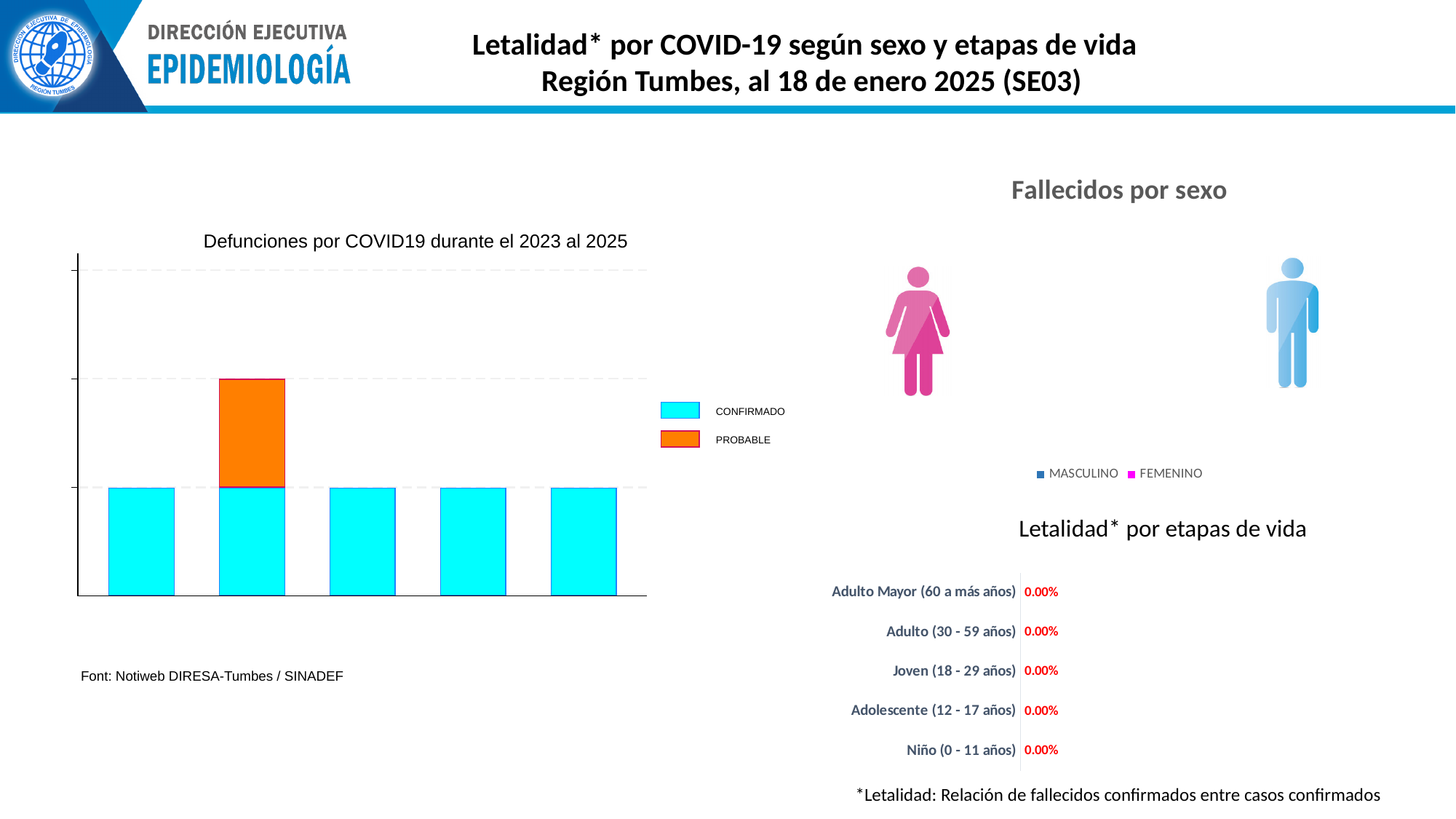
In the chart titled 'Letalidad* por etapas de vida', what is the value for Adulto Mayor (60 a más años)? 0.00% In the chart titled 'Letalidad* por etapas de vida', what is the value for Joven (18 - 29 años)? 0.00% In the chart titled 'Defunciones por COVID19 durante el 2023 al 2025', what kind of chart is shown? Bar chart In the chart titled 'Letalidad* por etapas de vida', what is the value for Niño (0 - 11 años)? 0.00% In the chart titled 'Defunciones por COVID19 durante el 2023 al 2025', what are the two legend entries? CONFIRMADO and PROBABLE In the chart titled 'Defunciones por COVID19 durante el 2023 al 2025', how many bars include an orange PROBABLE segment? 1 In the chart titled 'Defunciones por COVID19 durante el 2023 al 2025', how many series does the legend list? 2 In the chart titled 'Defunciones por COVID19 durante el 2023 al 2025', how many bars are plotted? 5 In the chart titled 'Fallecidos por sexo', how many series does the legend list? 2 In the chart titled 'Letalidad* por etapas de vida', what is the difference between the values for Adulto (30 - 59 años) and Adolescente (12 - 17 años)? 0.00% In the chart titled 'Defunciones por COVID19 durante el 2023 al 2025', which colour represents the CONFIRMADO series? Cyan In the chart titled 'Letalidad* por etapas de vida', how many age-group categories are listed? 5